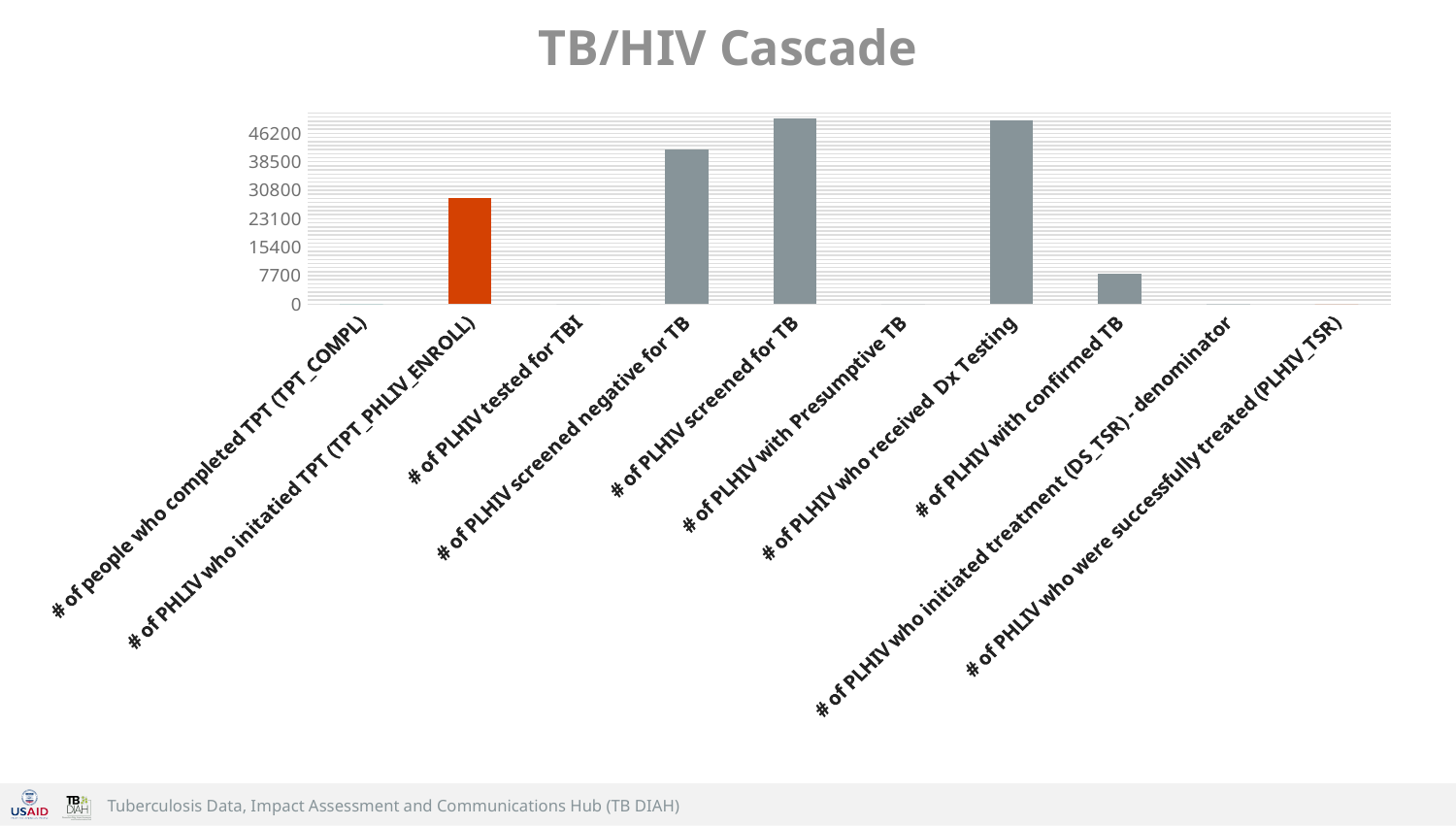
Is the value for # of PLHIV who received Dx Testing greater or less than 46200? greater Is the value for # of PHLIV who initatied TPT (TPT_PHLIV_ENROLL) greater or less than 30800? less Is the value for # of PHLIV who initatied TPT (TPT_PHLIV_ENROLL) greater or less than 23100? greater Which category's bar is coloured orange rather than grey? # of PHLIV who initatied TPT (TPT_PHLIV_ENROLL) Which is larger: # of PLHIV screened negative for TB or # of PLHIV screened for TB? # of PLHIV screened for TB How many categories are shown on the x axis of the chart? 10 What kind of chart is shown on the slide? bar chart Which is larger: # of PLHIV with confirmed TB or # of PHLIV who initatied TPT (TPT_PHLIV_ENROLL)? # of PHLIV who initatied TPT (TPT_PHLIV_ENROLL) What is the title of the chart? TB/HIV Cascade